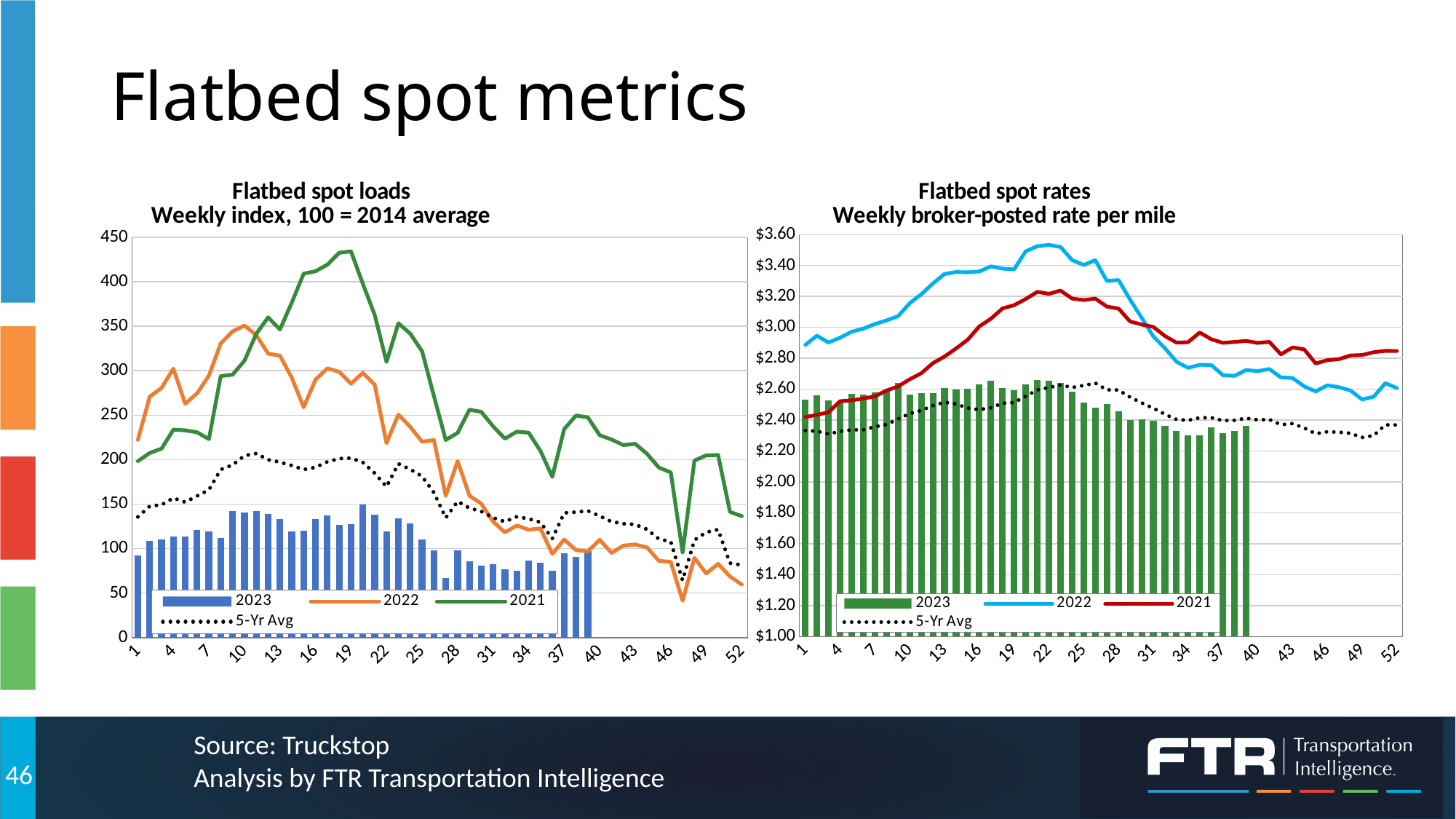
On the Flatbed spot loads chart, does the 2021 line rise or fall from week 20 to week 52? fall On the Flatbed spot loads chart, at week 19, which series is higher: 2021 or 2022? 2021 On the Flatbed spot rates chart, at week 22, which series is higher: 2022 or 2021? 2022 On the Flatbed spot rates chart, is the 2022 value at week 22 greater or less than $3.40? greater On the Flatbed spot rates chart, how many series does the legend list? 4 On the Flatbed spot loads chart, how many series does the legend list? 4 On the Flatbed spot loads chart, is the 2023 value at week 27 greater or less than 100? less On the Flatbed spot loads chart, which series is drawn as bars? 2023 What is the subtitle of the Flatbed spot rates chart? Weekly broker-posted rate per mile On the Flatbed spot loads chart, is the 2022 value at week 47 greater or less than 50? less On the Flatbed spot rates chart, does the 2022 line rise or fall from week 22 to week 52? fall